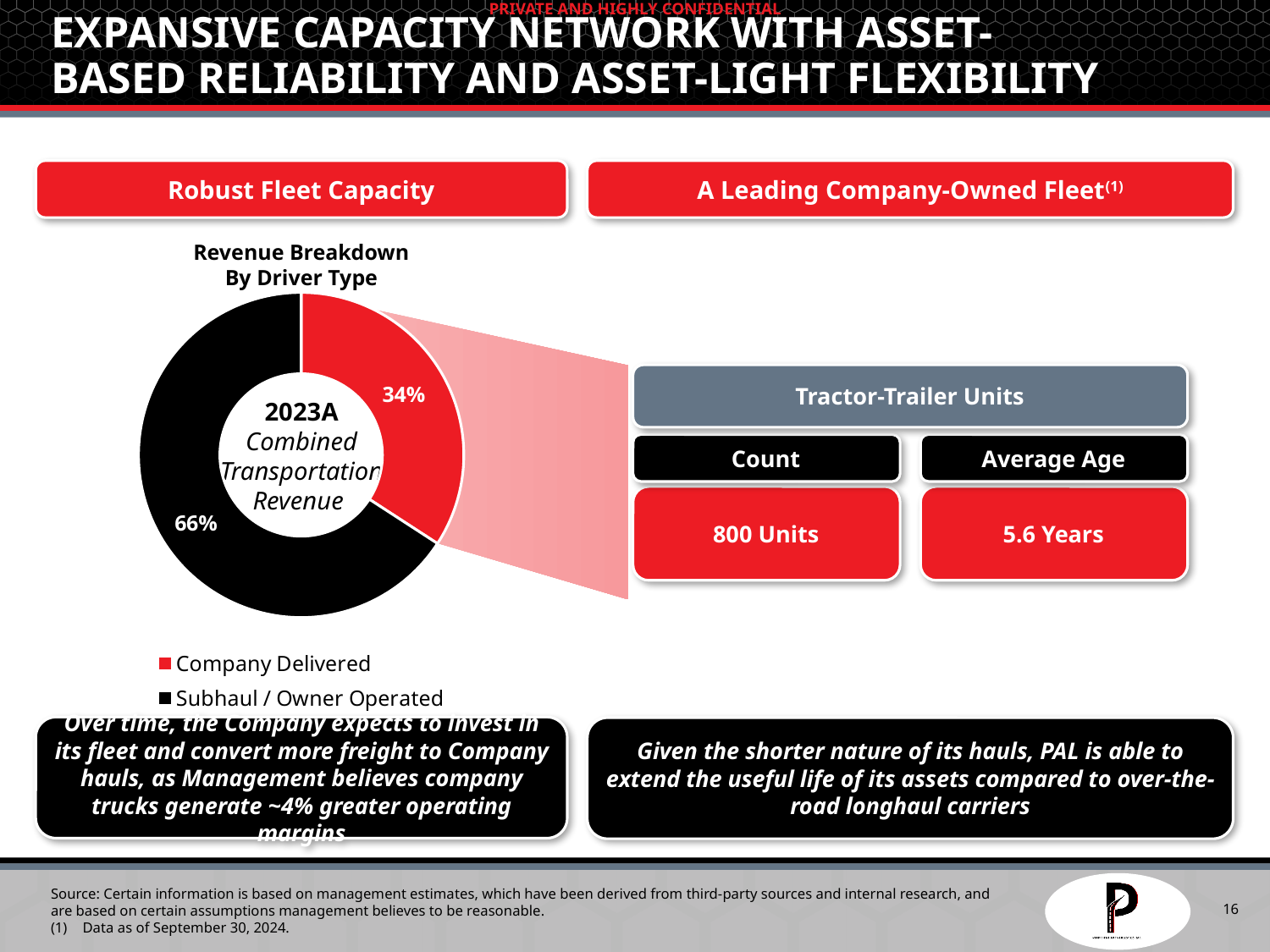
Which driver type has the largest share in the Revenue Breakdown By Driver Type chart? Subhaul / Owner Operated In the Revenue Breakdown By Driver Type chart, how many percentage points larger is the Subhaul / Owner Operated share than the Company Delivered share? 32 percentage points In the Revenue Breakdown By Driver Type chart, which is larger: Company Delivered or Subhaul / Owner Operated? Subhaul / Owner Operated What colour represents Company Delivered in the Revenue Breakdown By Driver Type chart? Red How many entries does the legend of the Revenue Breakdown By Driver Type chart list? 2 What share of 2023A combined transportation revenue is Subhaul / Owner Operated in the Revenue Breakdown By Driver Type chart? 66% What share of 2023A combined transportation revenue is Company Delivered in the Revenue Breakdown By Driver Type chart? 34% What kind of chart is the Revenue Breakdown By Driver Type chart? Donut (pie) chart What is the title of the chart on the left side of the slide? Revenue Breakdown By Driver Type What year and revenue measure is labelled in the centre of the Revenue Breakdown By Driver Type chart? 2023A Combined Transportation Revenue Which driver type has the smallest share in the Revenue Breakdown By Driver Type chart? Company Delivered How many slices does the Revenue Breakdown By Driver Type chart have? 2